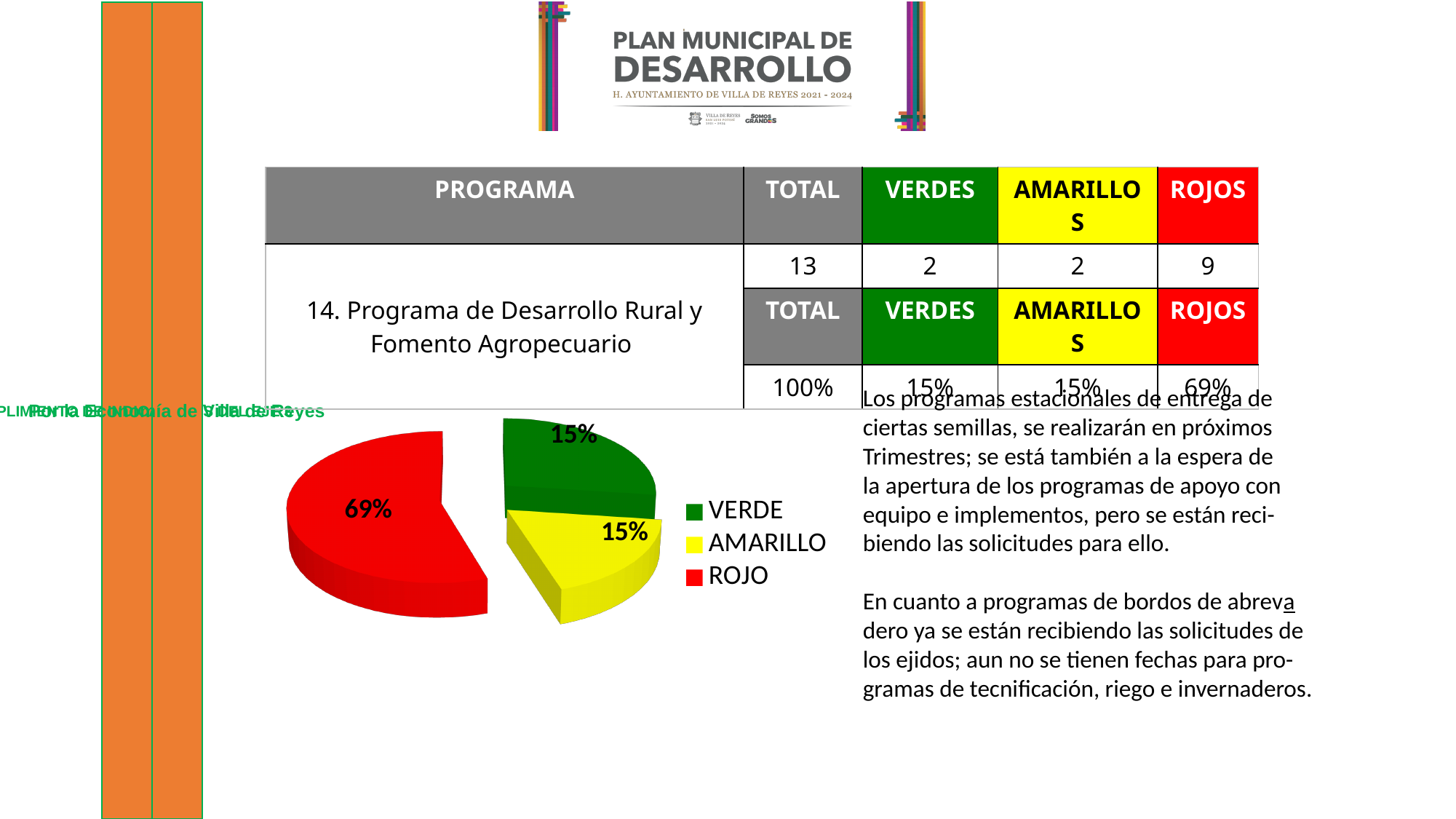
What share of the pie does the AMARILLO slice represent? 15% What share of the pie does the VERDE slice represent? 15% Is the ROJO share in the pie chart greater or less than 50%? greater Which is larger in the pie chart, the ROJO slice or the VERDE slice? ROJO How many entries does the legend of the pie chart list? 3 Which slice of the pie chart is the largest? ROJO What share of the pie does the ROJO slice represent? 69% What is the difference between the ROJO share and the AMARILLO share in the pie chart? 54% How many slices does the pie chart have? 3 What kind of chart is shown on the slide? pie chart What are the legend entries of the pie chart, in order? VERDE, AMARILLO, ROJO What colour is the ROJO slice in the pie chart? red